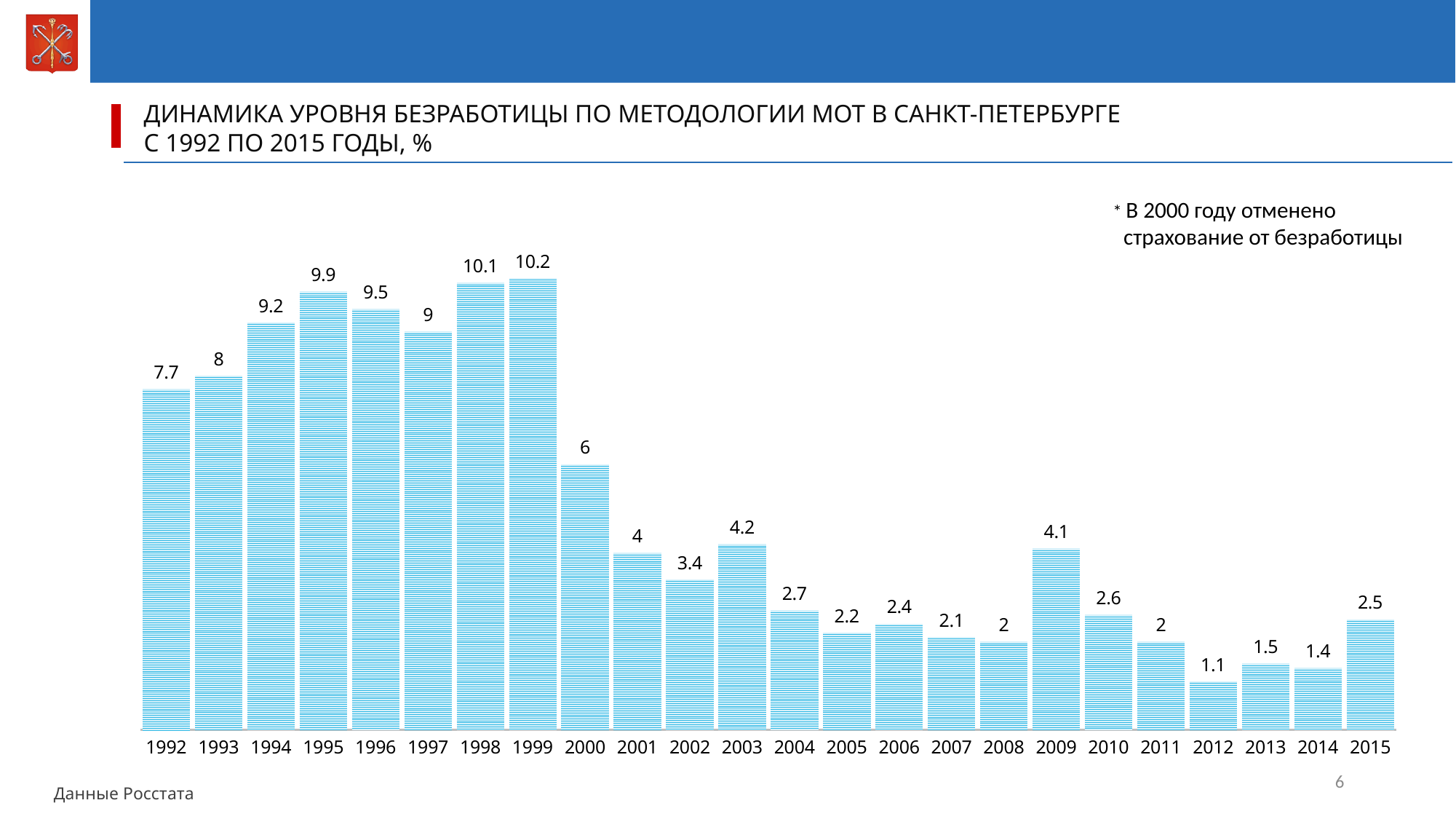
Do the values generally rise or fall from 1999 to 2008? Fall How many years are shown on the x axis of the chart? 24 Which year has the lowest unemployment rate on the chart? 2012 What is the unemployment rate shown for 1999? 10.2 What is the difference between the values for 1999 and 2000? 4.2 What is the difference between the values for 2009 and 2008? 2.1 What is the value shown for 2015? 2.5 Which year has the highest unemployment rate on the chart? 1999 Which year has a higher value, 1994 or 1996? 1996 Which year has a higher value, 2003 or 2010? 2003 What kind of chart is shown on the slide? Bar chart What is the value shown for 2009? 4.1